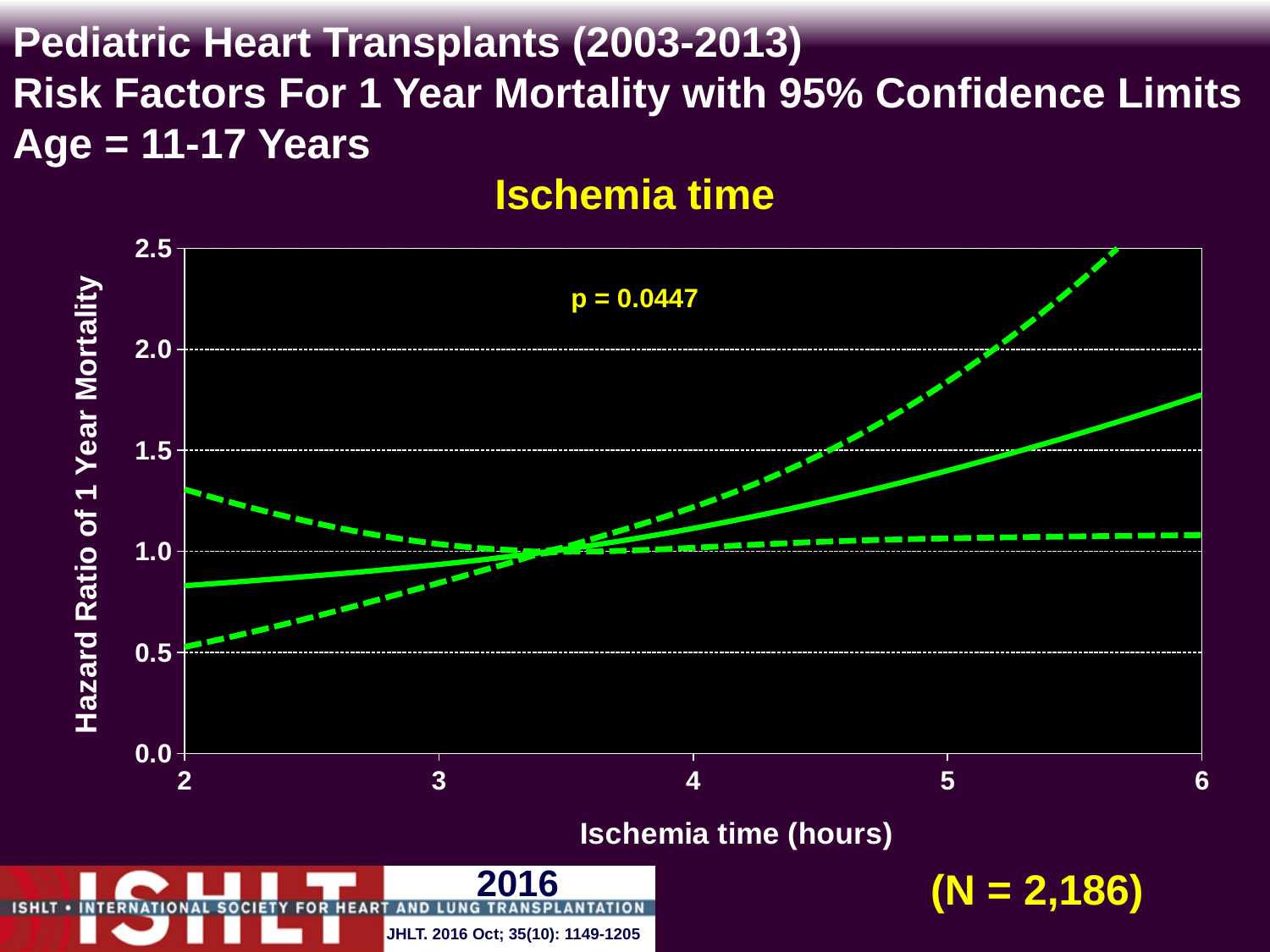
Is the hazard ratio on the solid line at an ischemia time of 6 hours greater or less than 1.5? greater At an ischemia time of 6 hours, which is larger: the upper dashed confidence limit or the solid hazard ratio line? the upper dashed confidence limit Does the solid hazard ratio line rise or fall as ischemia time increases from 2 to 6 hours? rise What p-value is printed on the chart? p = 0.0447 What is the label of the x axis? Ischemia time (hours) Is the hazard ratio on the solid line at an ischemia time of 2 hours greater or less than 1.0? less Is the lower dashed confidence limit at an ischemia time of 6 hours greater or less than 1.5? less What kind of chart is shown on the slide? line chart How many lines are plotted on the chart? 3